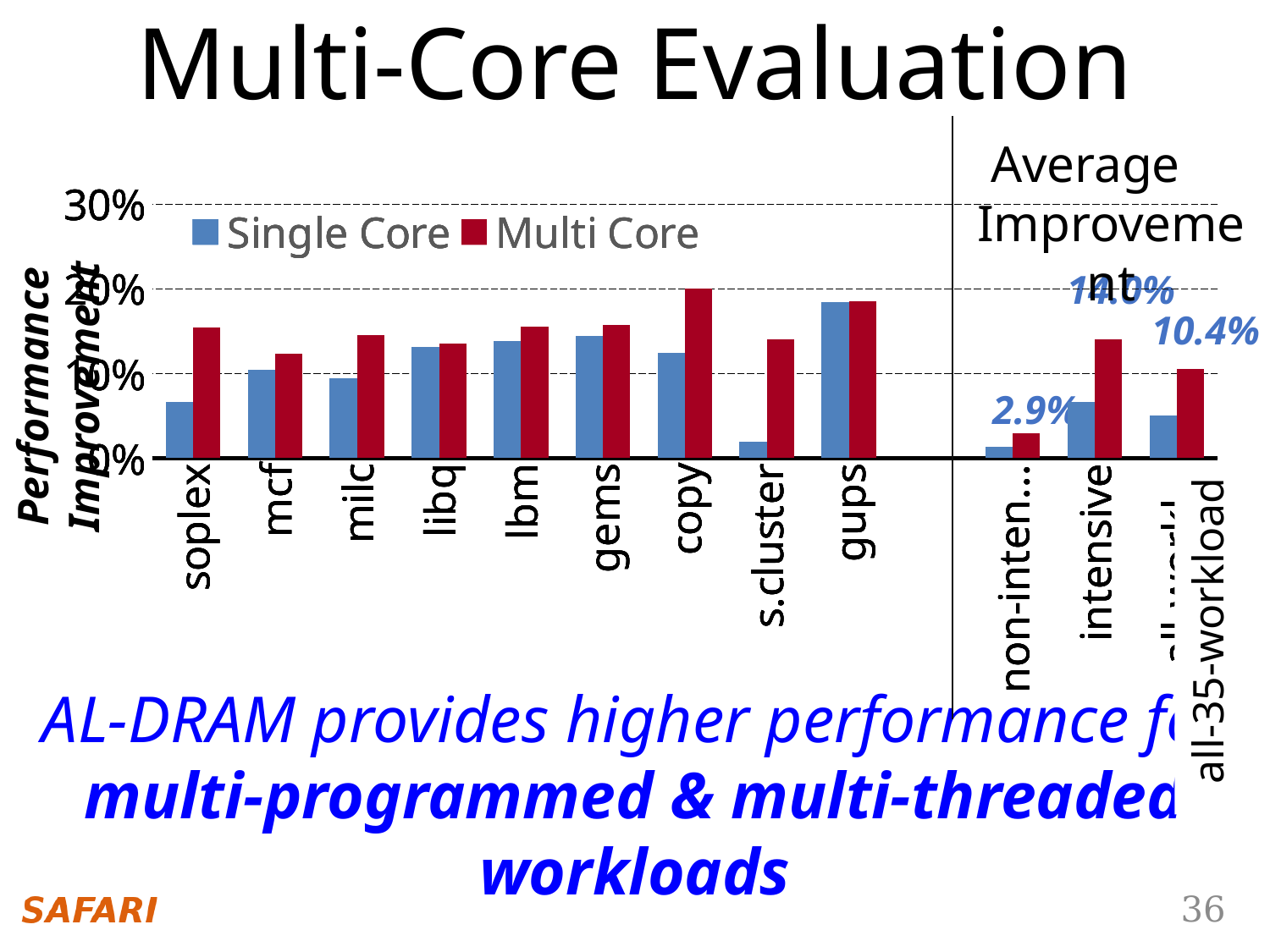
What are the two series named in the legend? Single Core and Multi Core What kind of chart is shown on the slide? bar chart What value is labelled for all-35-workload in the Average Improvement section? 10.4% Is the Single Core value for gups greater or less than 10%? greater Is the Single Core value for s.cluster greater or less than 10%? less Is the Multi Core value for soplex greater or less than 10%? greater Which benchmark has the highest Single Core performance improvement? gups Among the nine benchmarks left of the divider, which has the lowest Single Core performance improvement? s.cluster What colour are the Multi Core bars? red For soplex, which is larger: the Single Core or the Multi Core performance improvement? Multi Core What value is labelled for the intensive workloads in the Average Improvement section? 14.0% How many series does the legend list? 2